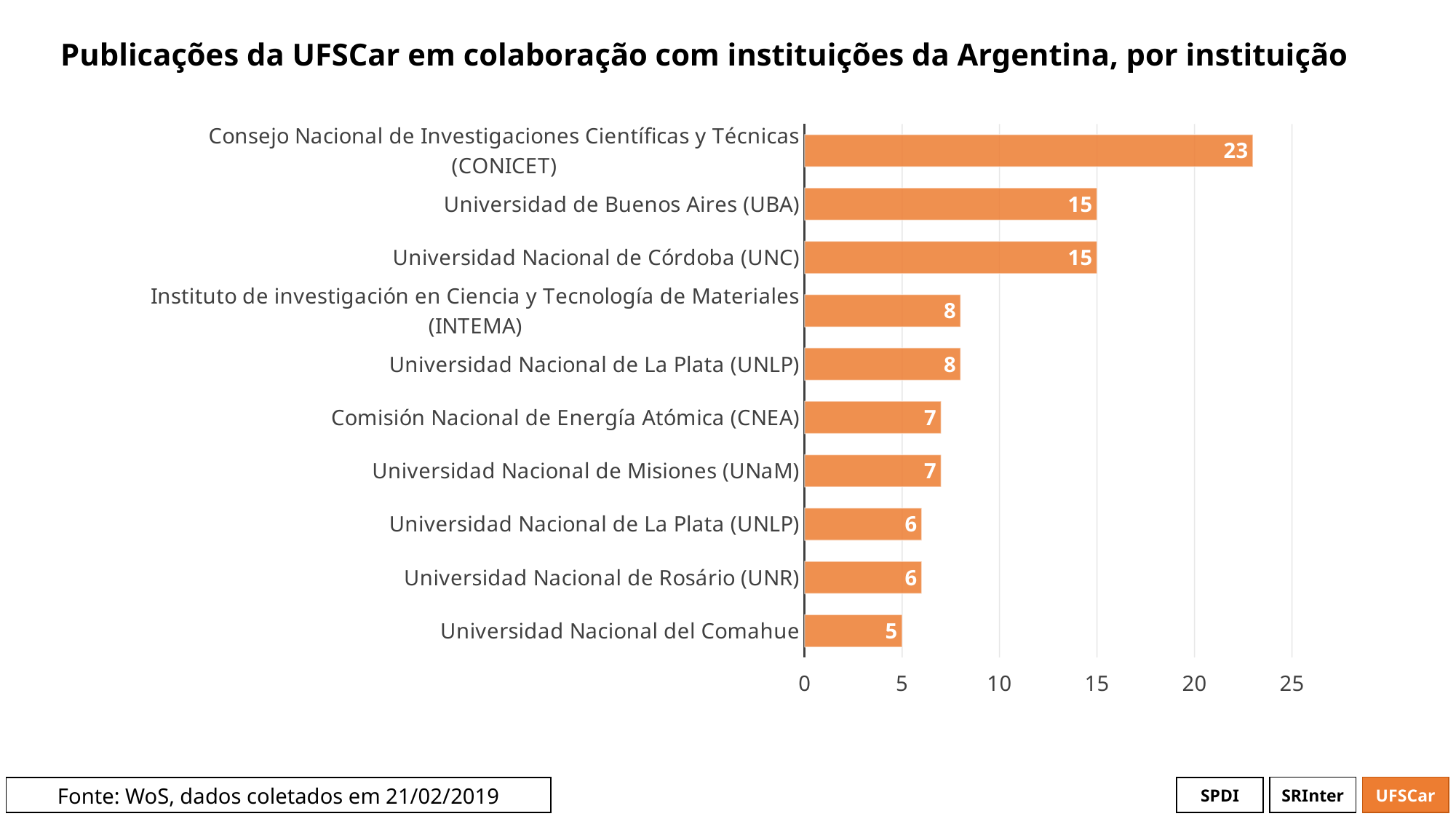
Is the value for CONICET greater or less than 20? greater Which institution has the lowest number of publications? Universidad Nacional del Comahue How many publications does the chart show for Consejo Nacional de Investigaciones Científicas y Técnicas (CONICET)? 23 Which has a larger value: Universidad Nacional de Córdoba (UNC) or Comisión Nacional de Energía Atómica (CNEA)? Universidad Nacional de Córdoba (UNC) How many bars are shown in the chart? 10 What is the value for Universidad Nacional del Comahue? 5 What is the value for Instituto de investigación en Ciencia y Tecnología de Materiales (INTEMA)? 8 What is the title of the chart? Publicações da UFSCar em colaboração com instituições da Argentina, por instituição Which institution has the highest number of publications? Consejo Nacional de Investigaciones Científicas y Técnicas (CONICET) What is the value for Universidad de Buenos Aires (UBA)? 15 What is the difference between the values for CONICET and Universidad de Buenos Aires (UBA)? 8 What kind of chart is shown on the slide? bar chart